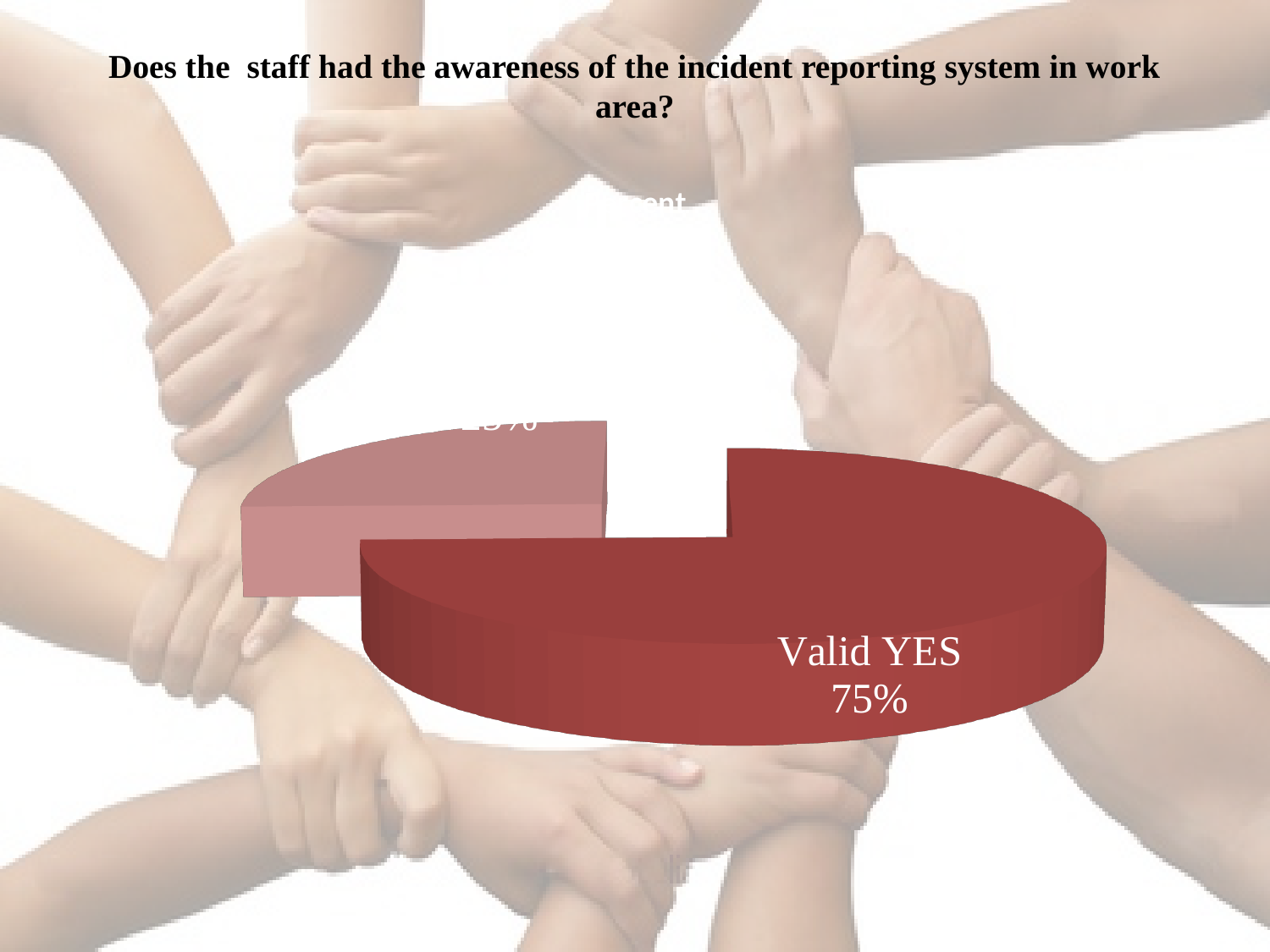
What kind of chart is shown on the slide? pie chart What colour is the Valid YES slice? dark red Which slice of the pie is the largest? Valid YES How many slices does the pie chart have? 2 What share of the pie does the Valid YES slice represent? 75% What question does the slide title ask? Does the staff had the awareness of the incident reporting system in work area? What is the value printed on the Valid YES slice? 75% Is the Valid YES slice larger or smaller than the other slice? larger